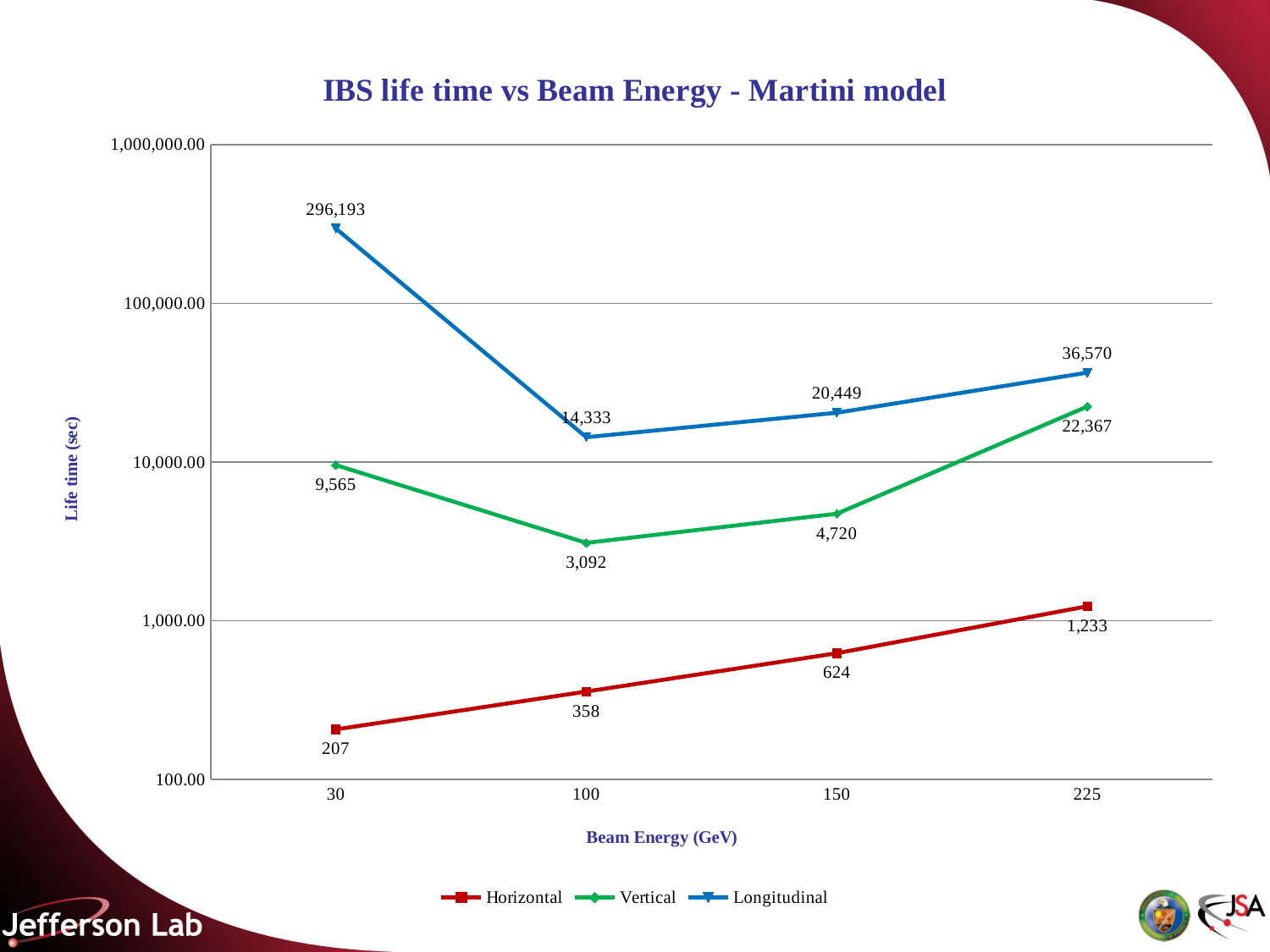
How many series does the legend list? 3 Which is larger at 150 GeV, the Vertical life time or the Horizontal life time? Vertical Is the Horizontal life time at 225 GeV greater or less than 1,000.00? greater Does the Horizontal life time rise or fall as beam energy increases? rise What is the Horizontal life time at a beam energy of 150 GeV? 624 What is the Vertical life time at a beam energy of 100 GeV? 3,092 What is the difference between the Longitudinal and Vertical life times at 225 GeV? 14,203 At which beam energy is the Longitudinal life time lowest? 100 What is the Longitudinal life time at a beam energy of 30 GeV? 296,193 At which beam energy is the Horizontal life time highest? 225 What kind of chart is shown on the slide? line chart How many beam energy values are plotted on the x axis? 4